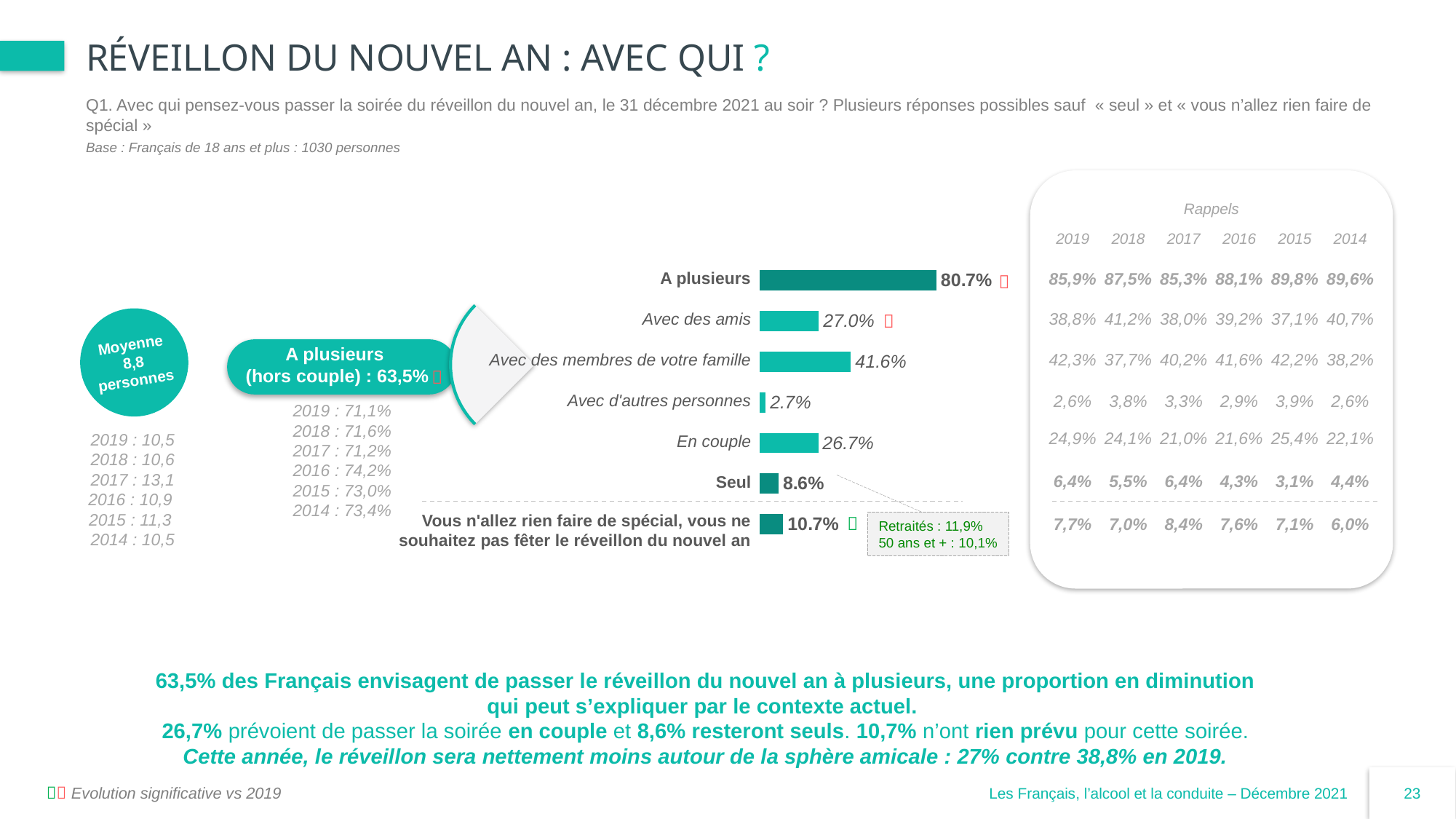
What is the value for "Avec des membres de votre famille"? 41.6% What is the value for "En couple"? 26.7% Which category has the lowest value in the bar chart? Avec d'autres personnes What is the value for "Vous n'allez rien faire de spécial, vous ne souhaitez pas fêter le réveillon du nouvel an"? 10.7% What is the value for "Seul"? 8.6% What is the value for "A plusieurs" in the bar chart? 80.7% What is the difference between "Avec des membres de votre famille" and "Avec des amis"? 14.6 percentage points Which is larger, "Avec des amis" or "En couple"? Avec des amis What is the difference between "Vous n'allez rien faire de spécial" and "Seul"? 2.1 percentage points What kind of chart is shown on the slide? Bar chart How many categories are shown in the bar chart? 7 Which category has the highest value in the bar chart? A plusieurs